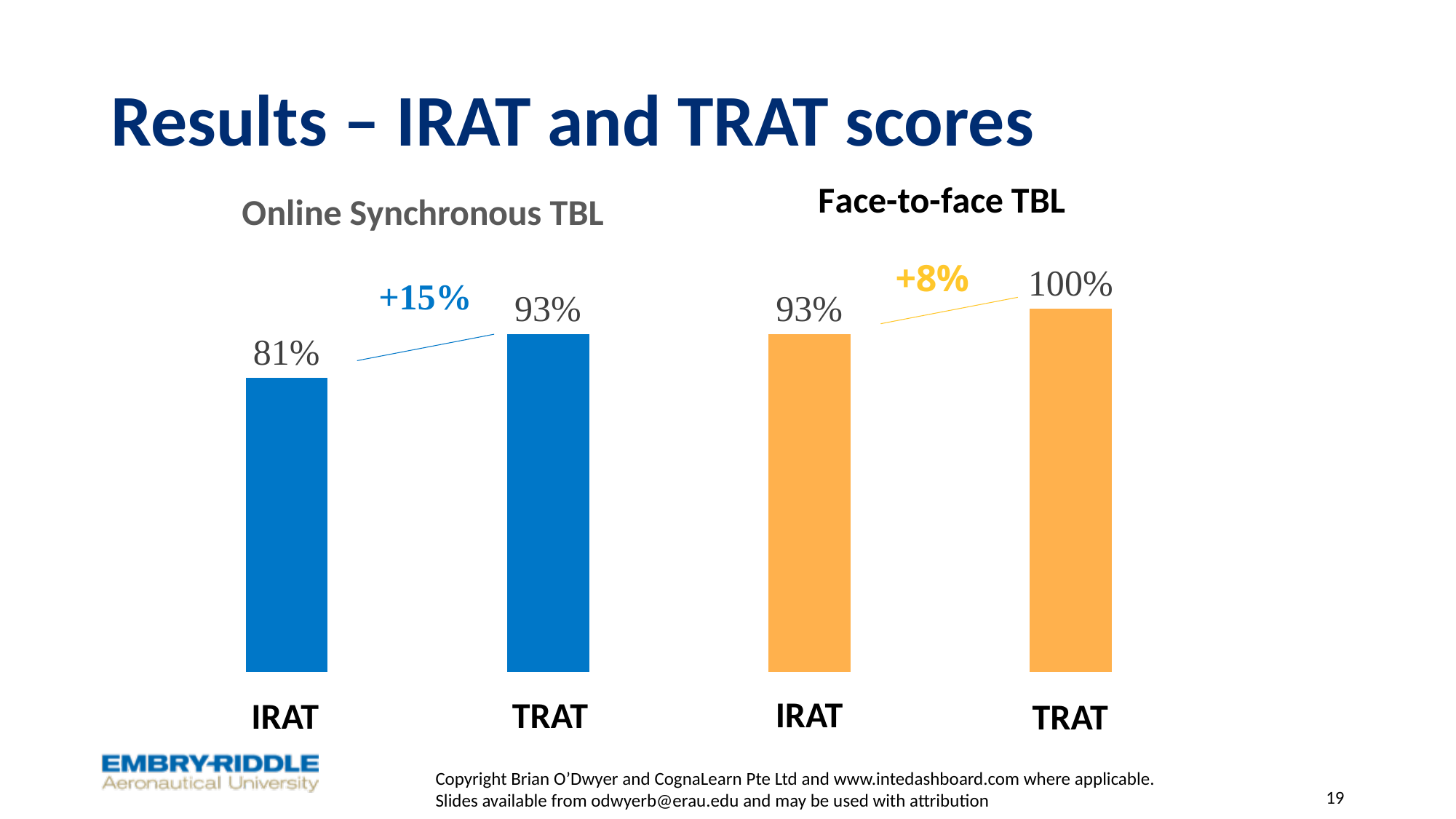
What percentage increase is annotated between IRAT and TRAT in the Face-to-face TBL chart? +8% In the Online Synchronous TBL chart, what is the difference between the TRAT and IRAT scores? 12% In the Face-to-face TBL chart, which category has the lower score? IRAT How many bars does the Online Synchronous TBL chart have? 2 In the Online Synchronous TBL chart, what is the IRAT score? 81% What type of chart is used for the Face-to-face TBL results? bar chart In the Face-to-face TBL chart, what is the difference between the TRAT and IRAT scores? 7% In the Online Synchronous TBL chart, which category has the higher score? TRAT In the Online Synchronous TBL chart, what is the TRAT score? 93% In the Face-to-face TBL chart, what is the IRAT score? 93% Is the IRAT score in the Online Synchronous TBL chart larger or smaller than the IRAT score in the Face-to-face TBL chart? smaller In the Face-to-face TBL chart, what is the TRAT score? 100%